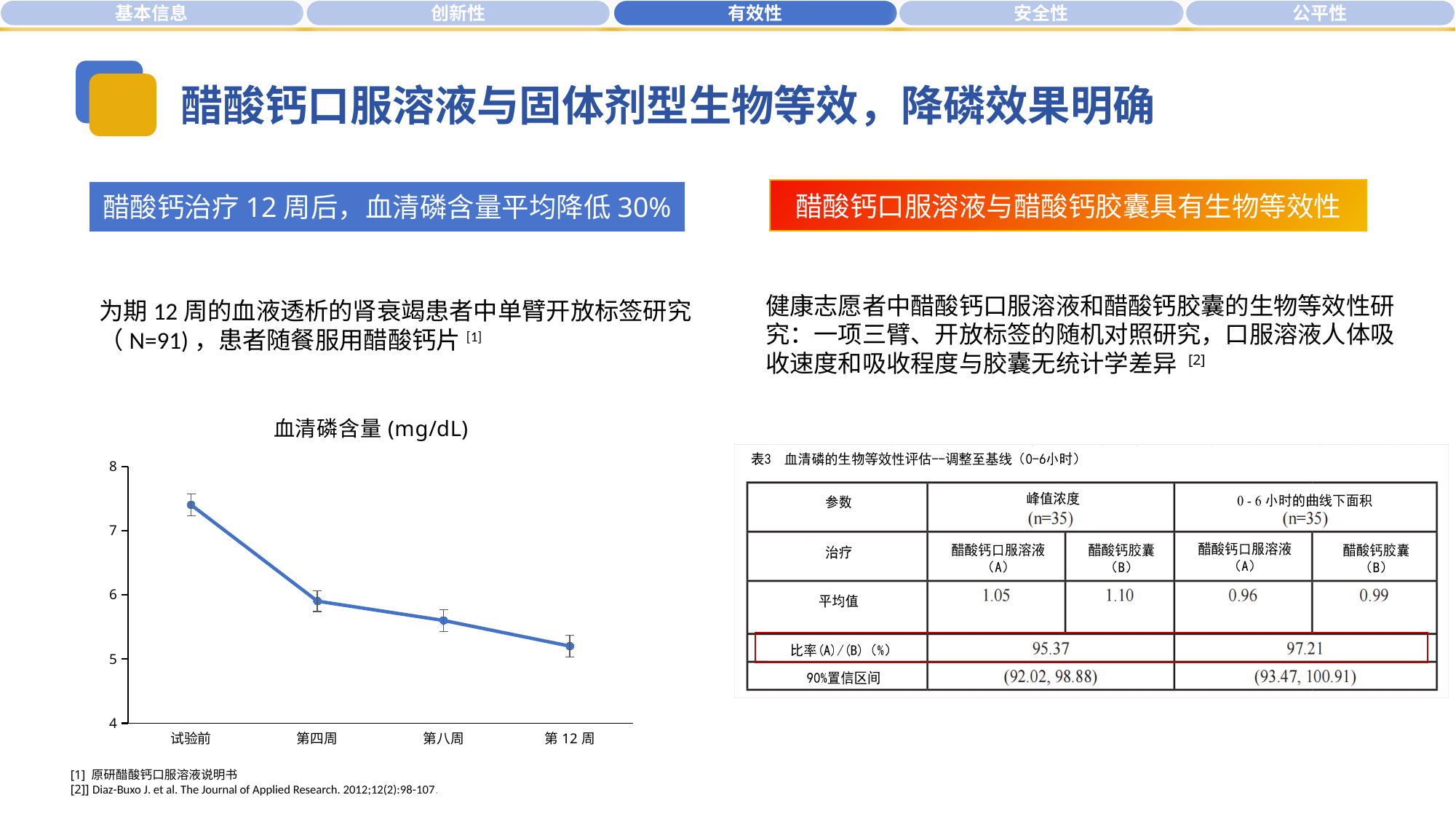
Is the value for 试验前 greater or less than 7? greater What kind of chart is shown on the slide? line chart Do the values rise or fall from 试验前 to 第 12 周 along the x axis? fall How many time points are plotted on the chart? 4 Which is larger, the value for 试验前 or the value for 第 12 周? 试验前 What is the title of the chart? 血清磷含量 (mg/dL) Which time point has the highest serum phosphorus value on the chart? 试验前 What is the lowest tick value shown on the y axis of the chart? 4 Is the value for 第八周 greater or less than 6? less Which time point has the lowest serum phosphorus value on the chart? 第 12 周